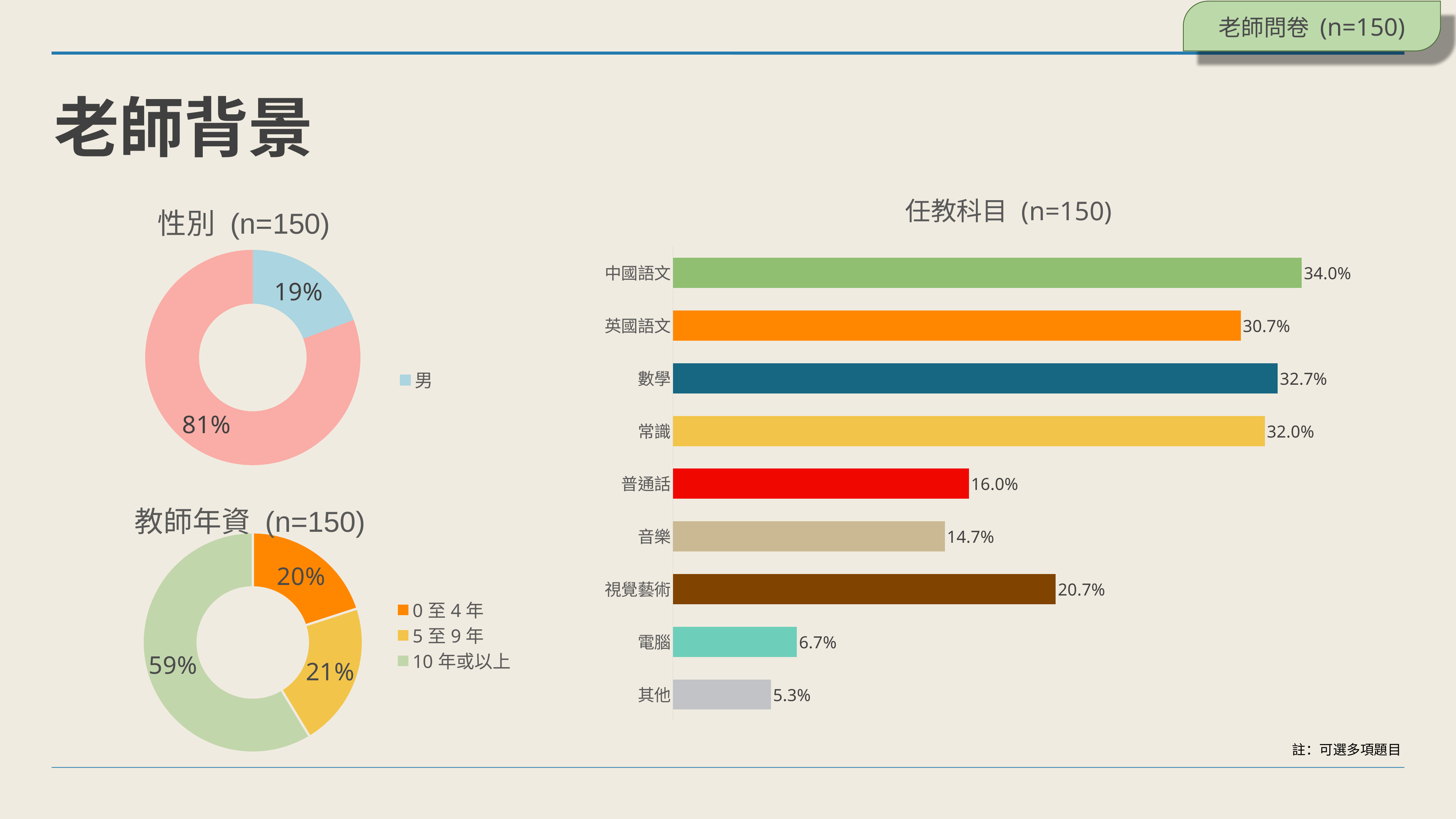
What kind of chart is the 任教科目 (n=150) chart? Bar chart In the 任教科目 (n=150) chart, what is the value for 中國語文? 34.0% In the 任教科目 (n=150) chart, which subject has the highest value? 中國語文 In the 性別 (n=150) chart, what share is 男? 19% In the 任教科目 (n=150) chart, which is larger, 視覺藝術 or 音樂? 視覺藝術 In the 任教科目 (n=150) chart, which subject has the lowest value? 其他 How many entries does the legend of the 教師年資 (n=150) chart list? 3 How many subjects are shown in the 任教科目 (n=150) chart? 9 In the 教師年資 (n=150) chart, which category has the largest share? 10 年或以上 In the 任教科目 (n=150) chart, what is the difference between 數學 and 普通話? 16.7% In the 任教科目 (n=150) chart, what is the value for 電腦? 6.7% In the 教師年資 (n=150) chart, what share is 10 年或以上? 59%